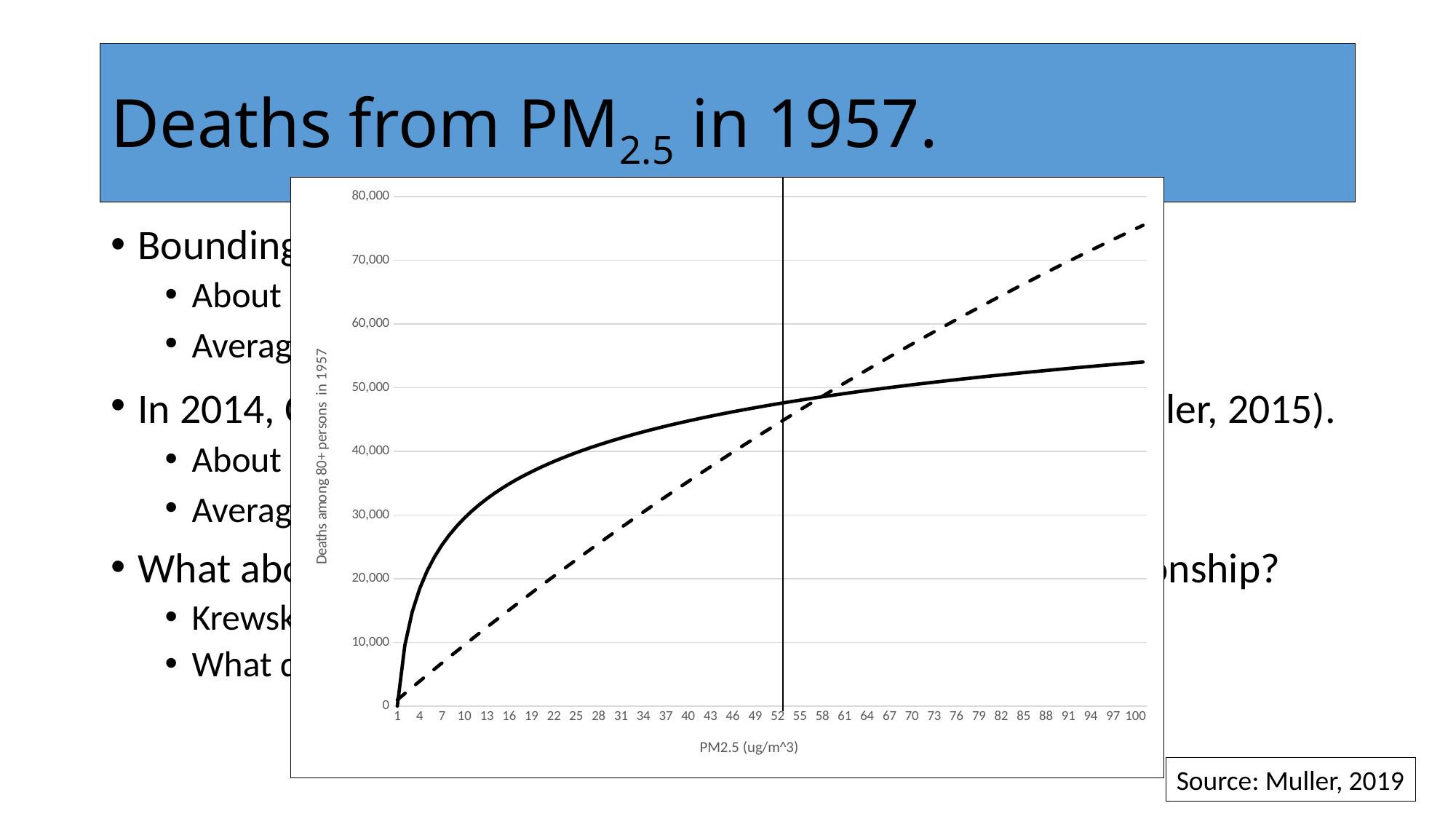
At PM2.5 = 25, which line has the higher value, the solid line or the dashed line? solid line Is the value of the dashed line at PM2.5 = 100 greater or less than 70,000? greater Is the value of the solid line at PM2.5 = 100 greater or less than 50,000? greater Is the value of the solid line at PM2.5 = 10 greater or less than 20,000? greater What is the title of the y axis of the chart? Deaths among 80+ persons in 1957 What kind of chart is shown on the slide? line chart At PM2.5 = 100, which line has the higher value, the solid line or the dashed line? dashed line Does the solid line rise or fall as PM2.5 increases along the x axis? rise What is the title of the x axis of the chart? PM2.5 (ug/m^3) Does the dashed line rise or fall as PM2.5 increases along the x axis? rise How many curves (solid and dashed) are plotted on the chart? 2